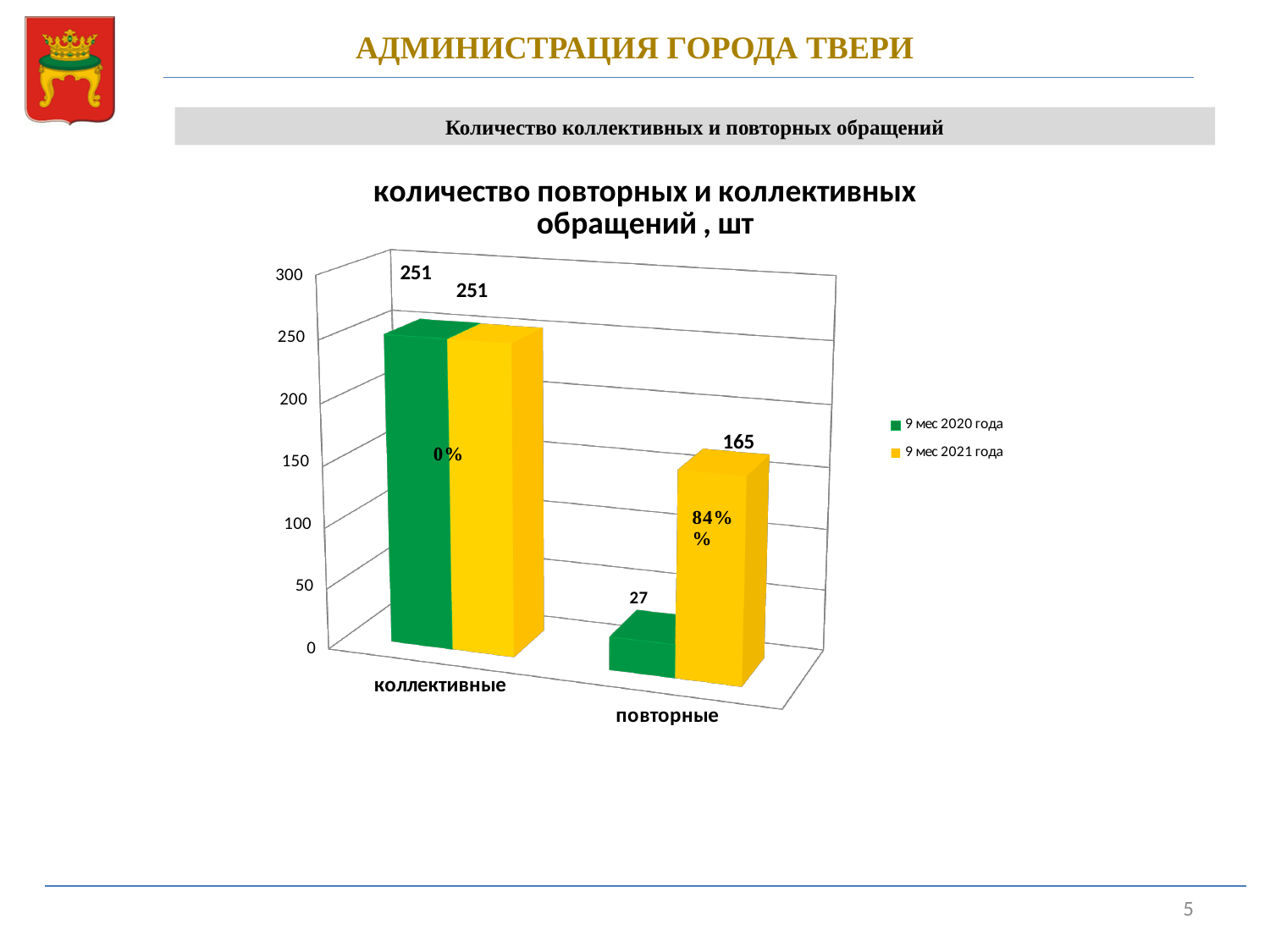
How many categories are shown on the x axis? 2 What is the value for повторные in the 9 мес 2020 года series? 27 Which category has the highest value in the 9 мес 2021 года series? коллективные What is the value for коллективные in the 9 мес 2020 года series? 251 What is the value for коллективные in the 9 мес 2021 года series? 251 What kind of chart is shown on the slide? bar chart What is the title of the chart? количество повторных и коллективных обращений , шт What is the value for повторные in the 9 мес 2021 года series? 165 Which is larger for повторные: the 9 мес 2020 года value or the 9 мес 2021 года value? 9 мес 2021 года Which category has the lowest value in the 9 мес 2020 года series? повторные What is the difference between the 9 мес 2021 года and 9 мес 2020 года values for повторные? 138 How many series does the legend list? 2